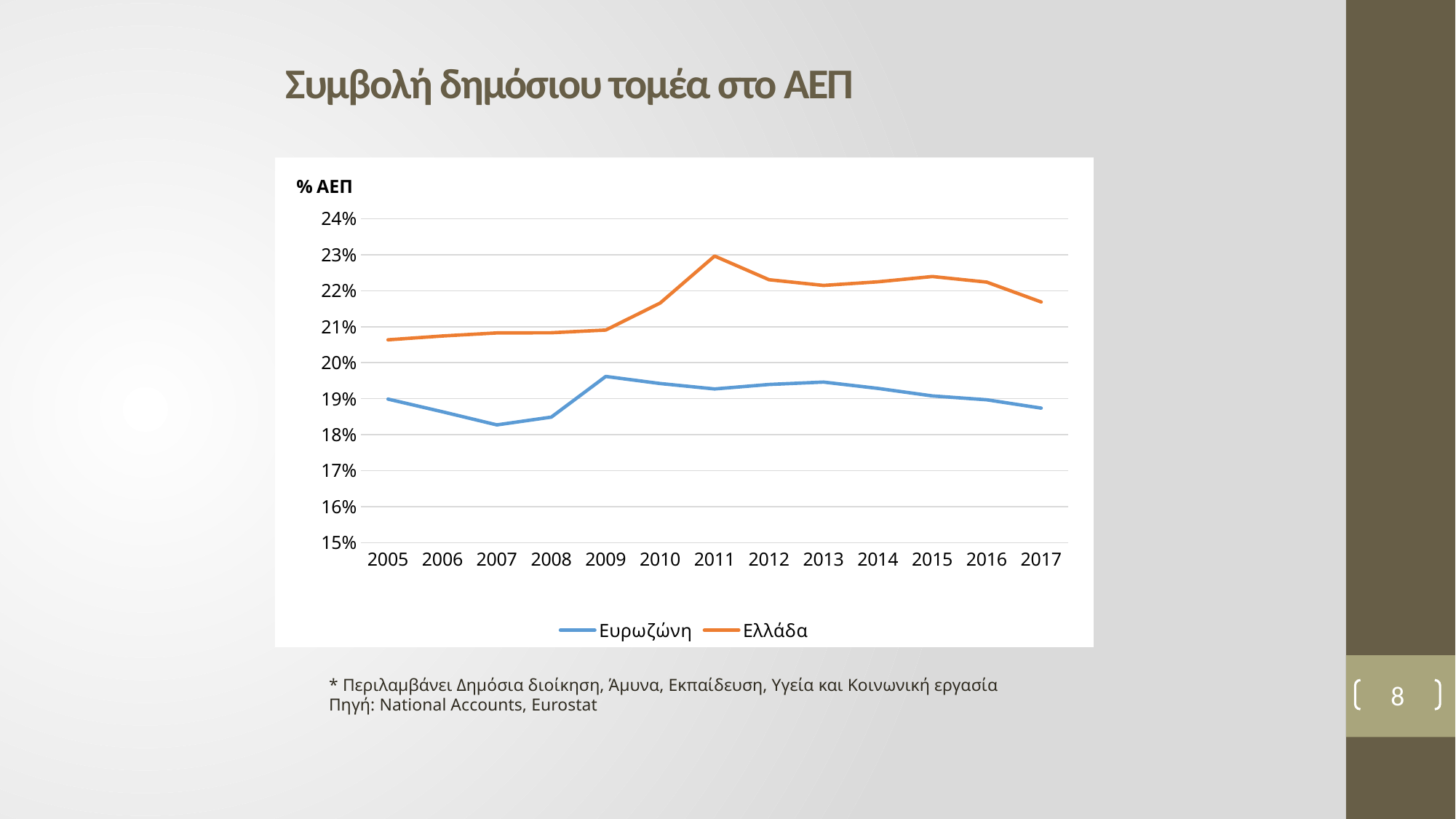
How many years are shown on the x axis? 13 How many series does the legend list? 2 Does the Ελλάδα series rise or fall from 2005 to 2011? rise Is the value for Ευρωζώνη in 2007 greater or less than 19%? less Is the value for Ελλάδα in 2011 greater or less than 22%? greater Which series has the higher value in 2011, Ευρωζώνη or Ελλάδα? Ελλάδα What is the label shown above the vertical axis of the chart? % ΑΕΠ In which year does the Ευρωζώνη series reach its lowest value? 2007 In which year does the Ελλάδα series have its lowest value? 2005 Is the value for Ευρωζώνη in 2009 greater or less than 19%? greater What kind of chart is shown on the slide? line chart In which year does the Ελλάδα series reach its highest value? 2011